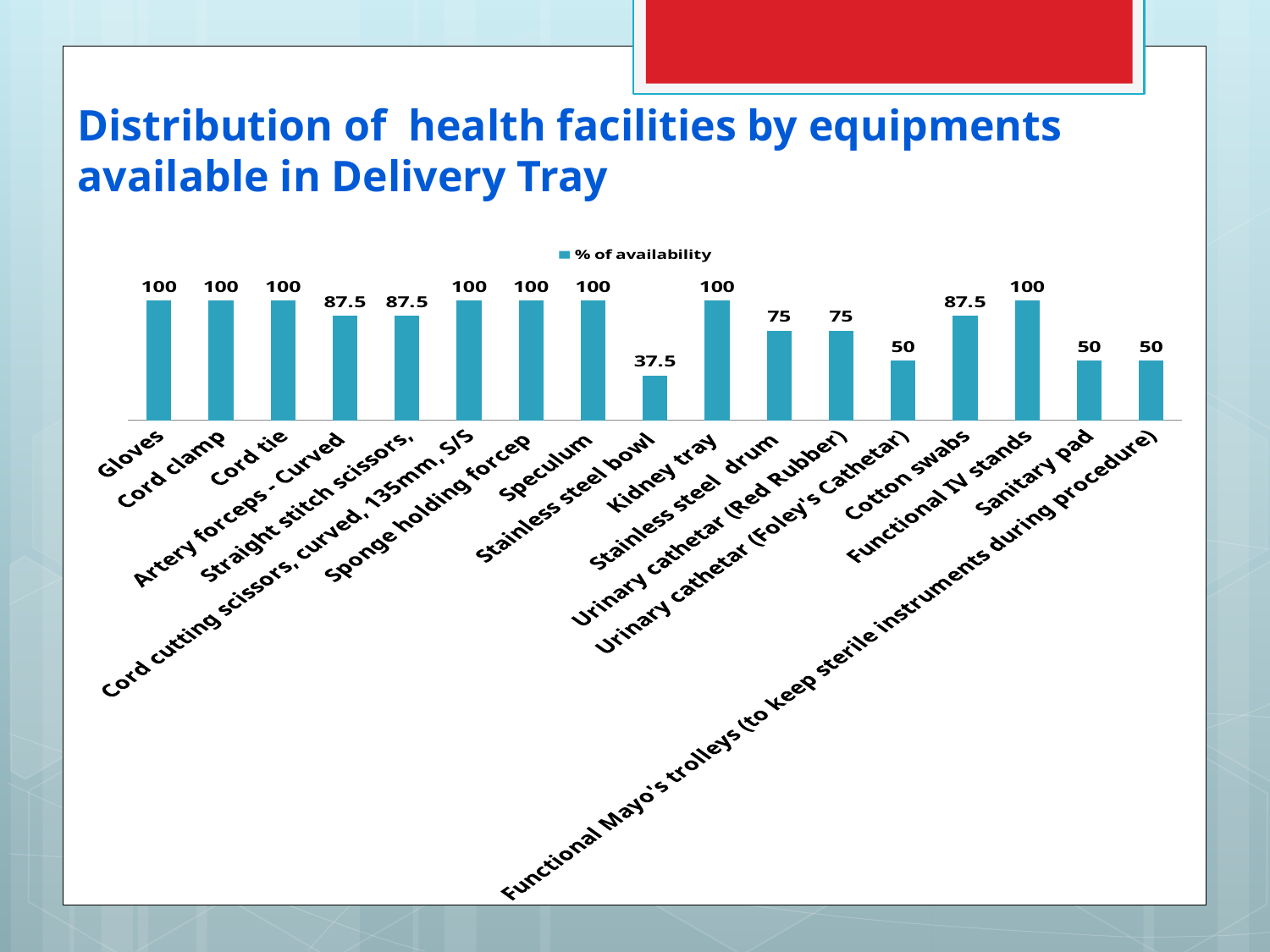
What is the value for Sanitary pad? 50 How many categories are shown on the x axis? 17 What is the difference between the values for Artery forceps - Curved and Urinary cathetar (Red Rubber)? 12.5 Which category has the lowest value? Stainless steel bowl What kind of chart is shown on the slide? Bar chart What is the value for Cotton swabs? 87.5 How many series does the legend list? 1 What is the legend entry for the series? % of availability What is the value for Stainless steel drum? 75 What is the value for Stainless steel bowl? 37.5 What is the difference between the values for Kidney tray and Stainless steel bowl? 62.5 Which is larger, the value for Cotton swabs or the value for Sanitary pad? Cotton swabs